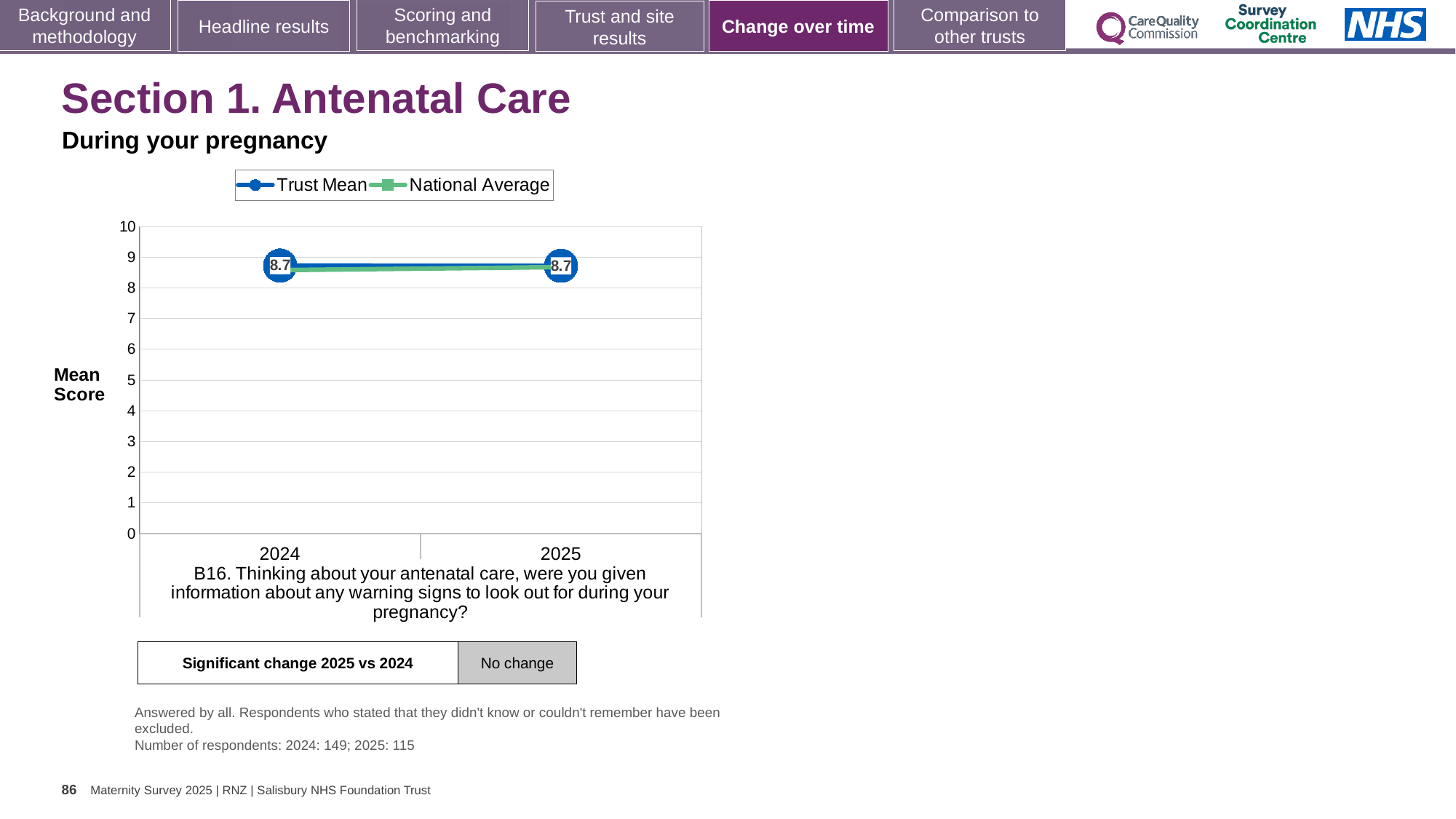
Is the Trust Mean value for 2025 greater or less than 8? greater What is the Trust Mean value for 2024? 8.7 How many series does the chart legend list? 2 What are the two series named in the chart legend? Trust Mean and National Average What is the label on the y axis of the chart? Mean Score What kind of chart is shown on the slide? Line chart How many years are shown on the x axis of the chart? 2 Is the National Average value for 2024 greater or less than 5? greater What is the Trust Mean value for 2025? 8.7 What is the difference between the Trust Mean in 2025 and in 2024? 0 Does the Trust Mean rise, fall or stay the same from 2024 to 2025? Stays the same